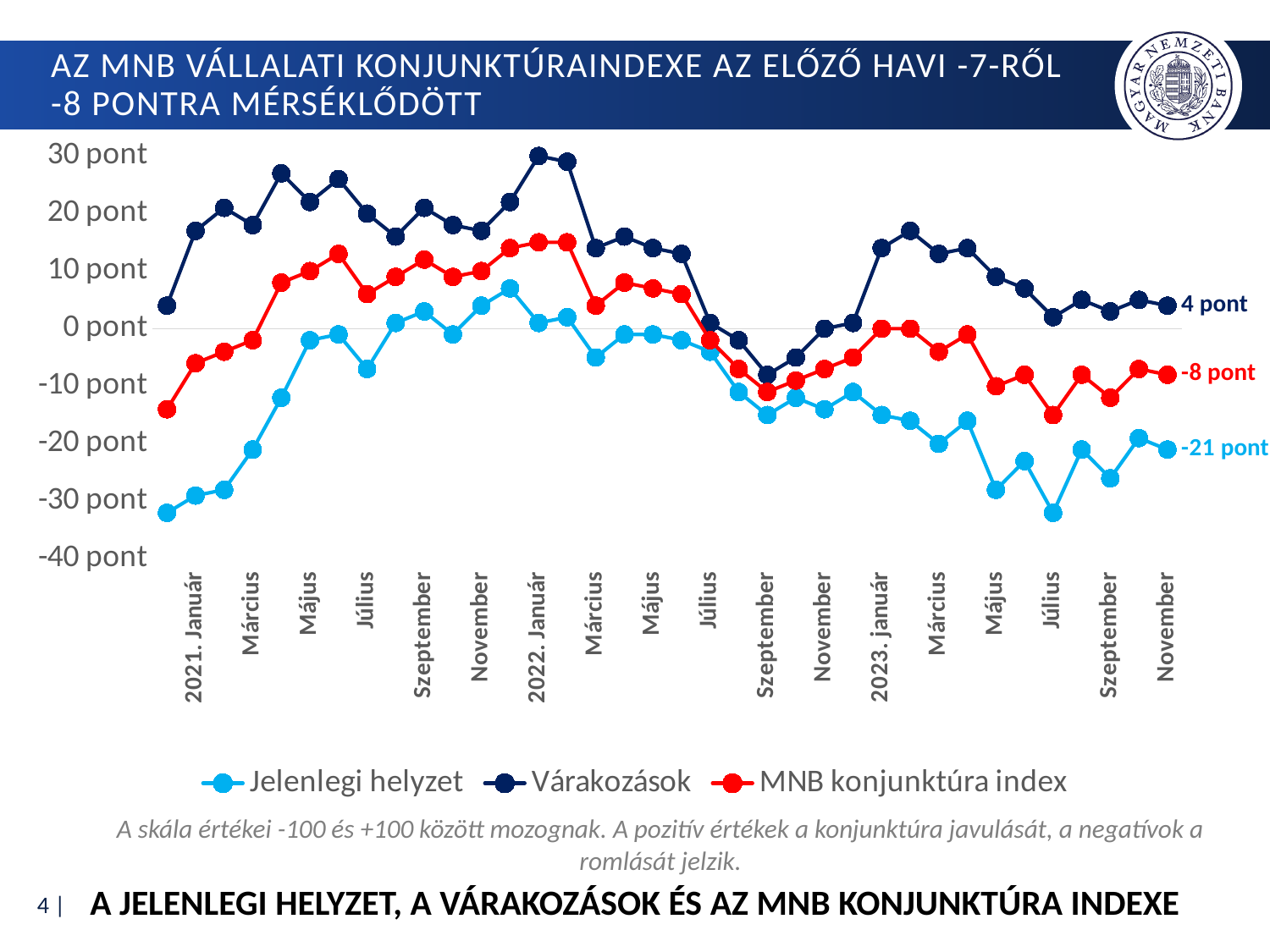
How many series does the legend list? 3 What kind of chart is shown on the slide? line chart At the last point (November 2023), which series has the lowest value? Jelenlegi helyzet At the last point (November 2023), which series has the highest value? Várakozások What is the value of the Várakozások series at the last point (November 2023)? 4 pont What is the difference between the Várakozások value and the Jelenlegi helyzet value at the last point (November 2023)? 25 pont What is the value of the MNB konjunktúra index at the last point (November 2023)? -8 pont Which colour is used for the MNB konjunktúra index series? red What is the value of the Jelenlegi helyzet series at the last point (November 2023)? -21 pont Is the value of Várakozások in 2022. Január greater or less than 20 pont? greater Does the Várakozások series rise or fall between 2022. Január and 2022. Szeptember? fall